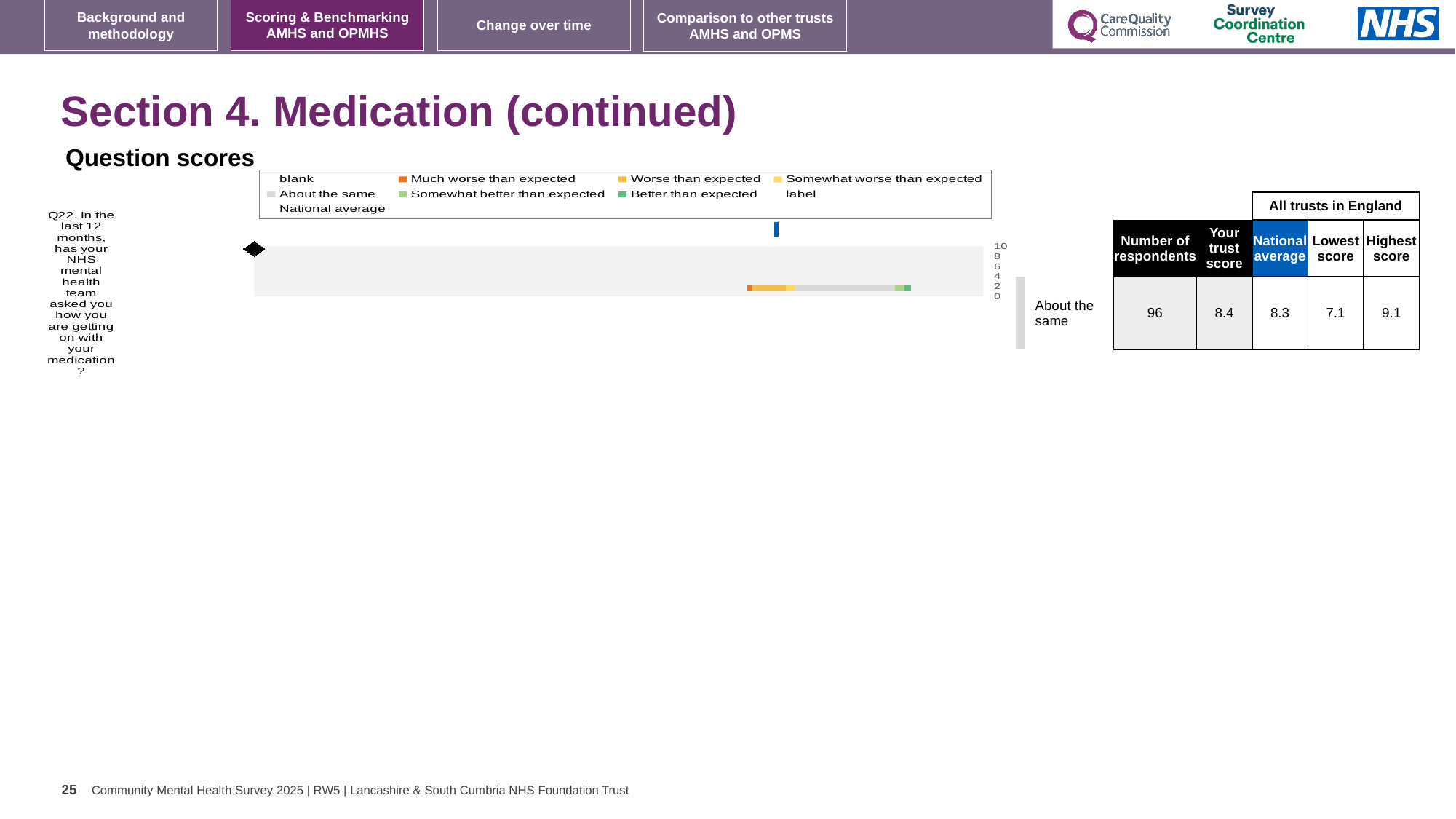
Which is larger for Q22, the trust's score or the national average? the trust's score How many entries does the chart legend list? 9 What is the difference between the highest score (9.1) and the lowest score (7.1) for Q22? 2.0 What is the heading printed above the chart? Question scores What is the highest score among all trusts in England for Q22? 9.1 What colour represents 'Much worse than expected' in the chart legend? orange How many questions are plotted in the chart? 1 What kind of chart is shown under 'Question scores'? bar chart What is the trust's score for Q22? 8.4 Which benchmark category is the trust's Q22 result labelled as? About the same How many respondents answered Q22? 96 What is the national average score for Q22? 8.3